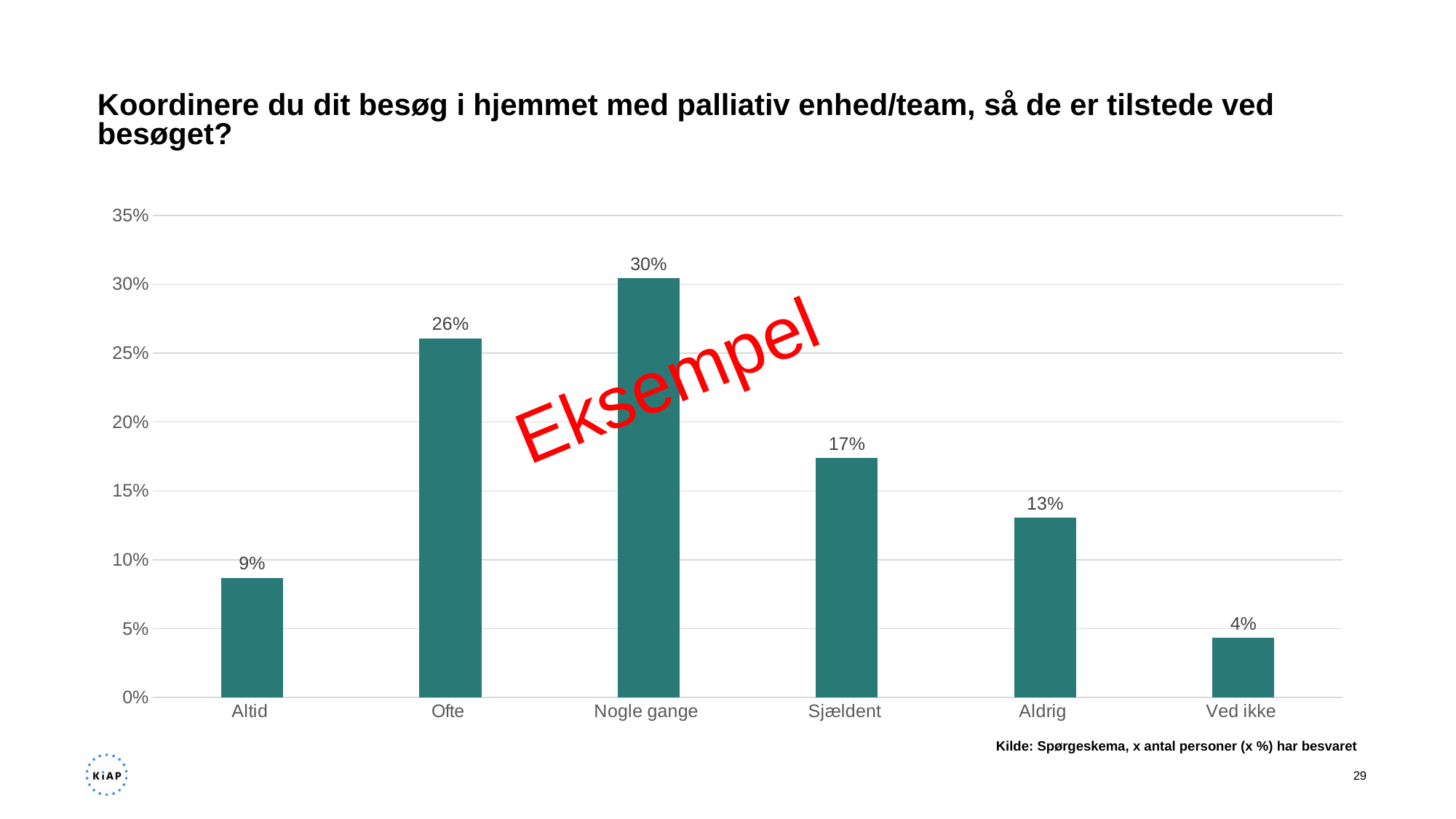
What is the value for Nogle gange? 30% Which category has the highest value? Nogle gange What is the difference between the values for Nogle gange and Ved ikke? 26% Which category has the lowest value? Ved ikke Is the value for Sjældent greater or less than 20%? less What is the value for Ved ikke? 4% What red word is written diagonally across the chart? Eksempel What is the value for Altid? 9% What is the difference between the values for Ofte and Sjældent? 9% Which is larger, the value for Aldrig or the value for Altid? Aldrig What kind of chart is shown on the slide? bar chart How many categories are shown on the x axis? 6